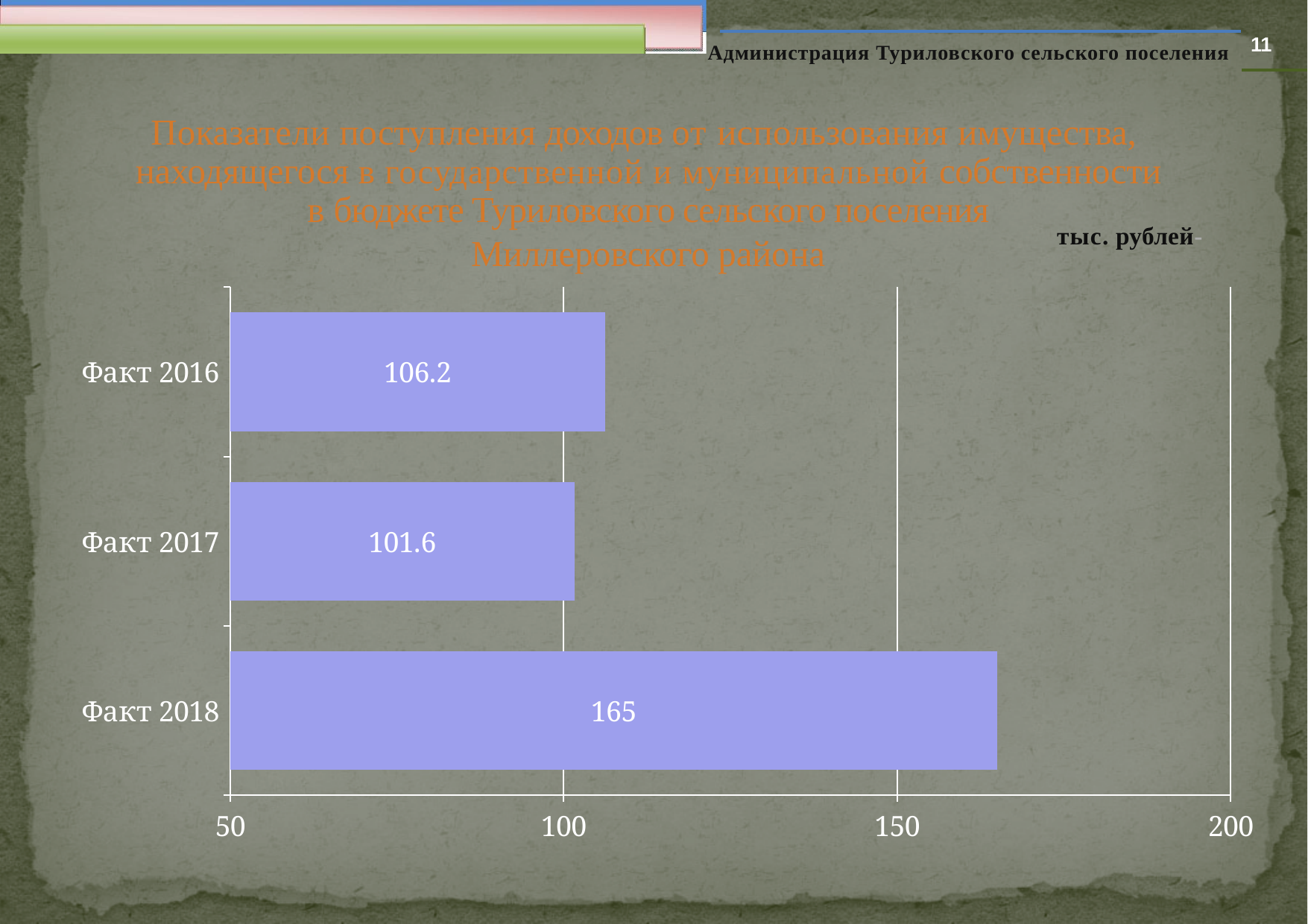
Which category has the highest value? Факт 2018 What kind of chart is shown on the slide? bar chart Which category has the lowest value? Факт 2017 How many categories are shown in the chart? 3 What unit is indicated for the chart values? тыс. рублей What is the difference between the values for Факт 2018 and Факт 2017? 63.4 Is the value for Факт 2018 greater or less than 150? greater What is the value for Факт 2016? 106.2 Which is larger, the value for Факт 2016 or Факт 2018? Факт 2018 What is the value for Факт 2017? 101.6 What is the value for Факт 2018? 165 What is the difference between the values for Факт 2016 and Факт 2017? 4.6